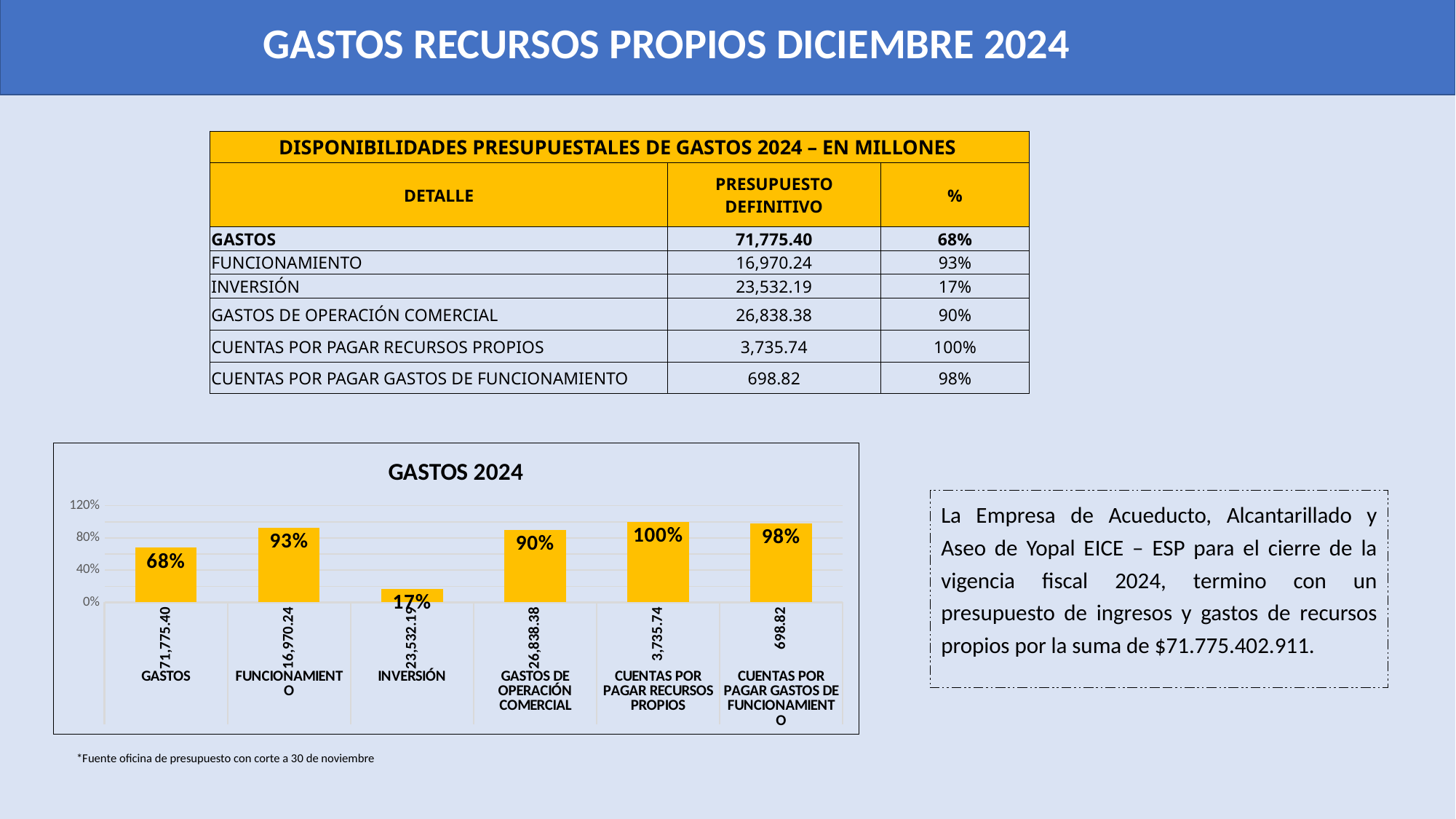
Which category has the lowest percentage in the chart? INVERSIÓN How many bars are plotted in the GASTOS 2024 chart? 6 What percentage is shown for INVERSIÓN in the chart? 17% What is the title of the chart? GASTOS 2024 What is the amount shown under the GASTOS bar in the chart? 71,775.40 What percentage is shown for GASTOS DE OPERACIÓN COMERCIAL in the chart? 90% Which is larger, the percentage for FUNCIONAMIENTO or for GASTOS DE OPERACIÓN COMERCIAL? FUNCIONAMIENTO Which category has the highest percentage in the chart? CUENTAS POR PAGAR RECURSOS PROPIOS What percentage is shown for FUNCIONAMIENTO in the chart? 93% What is the difference in percentage points between CUENTAS POR PAGAR GASTOS DE FUNCIONAMIENTO and GASTOS? 30% What type of chart is shown on the slide? bar chart Is the value for INVERSIÓN greater or less than 40%? less